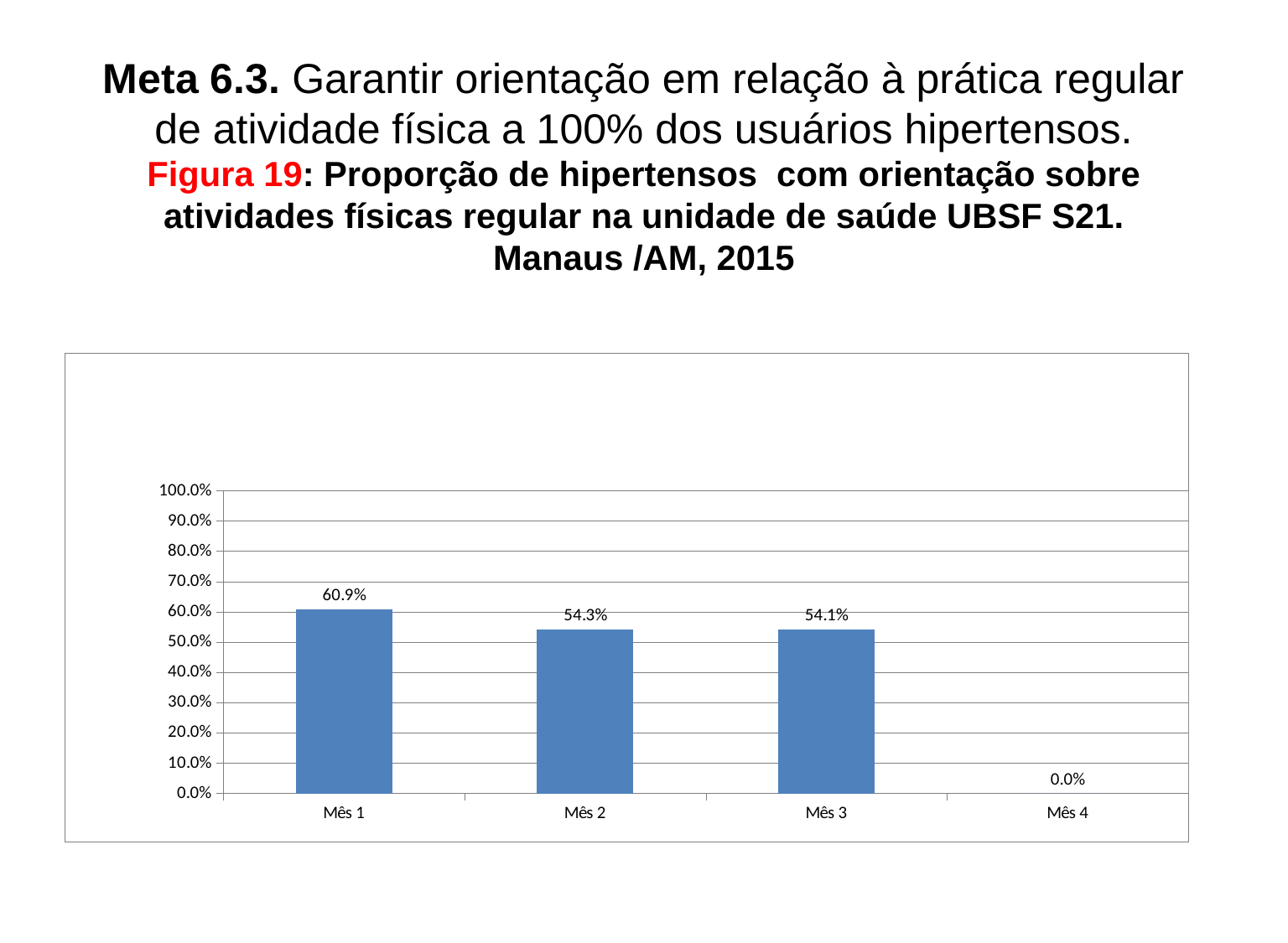
What is the value for Mês 2? 54.3% How many months are shown on the x axis? 4 What is the value for Mês 4? 0.0% Which month has the highest value? Mês 1 Which month has the lowest value? Mês 4 What kind of chart is shown on the slide? Bar chart What is the difference between the values for Mês 1 and Mês 2? 6.6% What is the value for Mês 3? 54.1% What is the value for Mês 1? 60.9% Which is larger, the value for Mês 1 or the value for Mês 3? Mês 1 Do the values rise or fall from Mês 1 to Mês 4? Fall Is the value for Mês 2 greater or less than 50.0%? greater